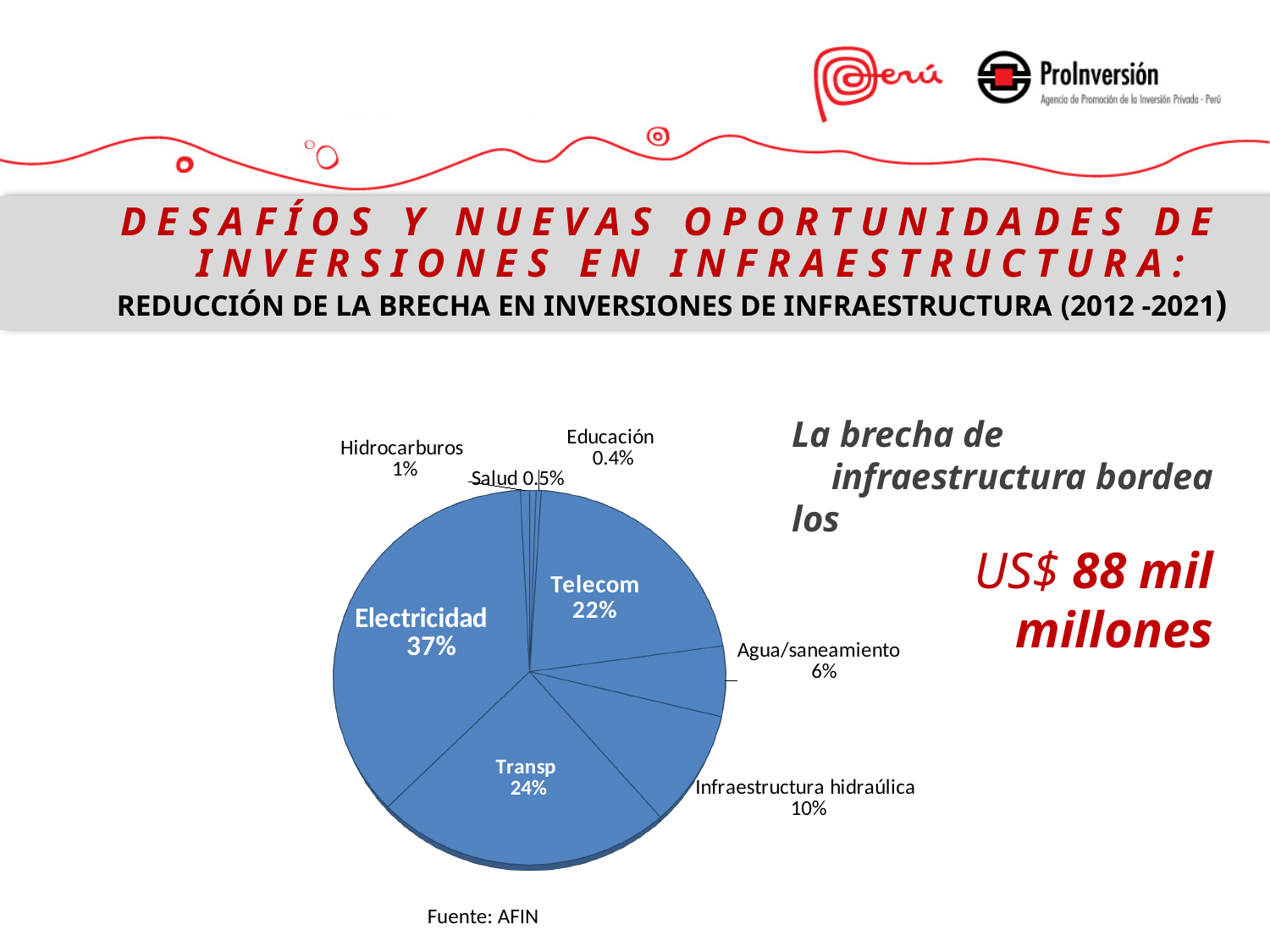
What is the value shown for Agua/saneamiento? 6% What is the value shown for Transp? 24% What source is cited below the chart? AFIN Which category has the smallest slice of the pie? Educación What share of the pie does Electricidad represent? 37% What is the difference between the shares of Electricidad and Telecom? 15% What kind of chart is shown on the slide? pie chart Which is larger, the share for Transp or the share for Telecom? Transp How many categories are shown in the pie chart? 8 What is the value shown for Infraestructura hidraúlica? 10% Which category has the largest slice of the pie? Electricidad What is the value shown for Telecom? 22%